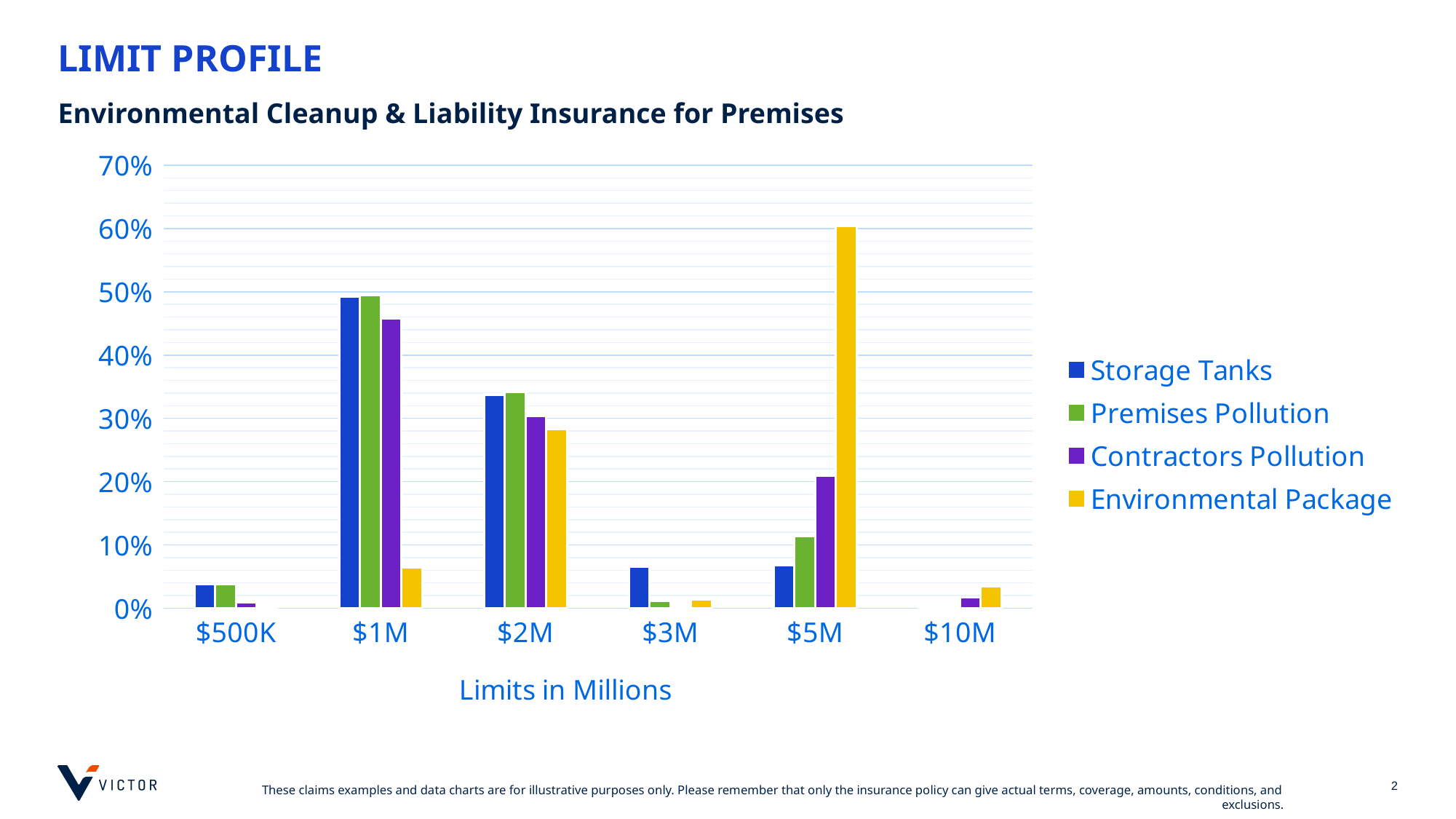
Is the value for Environmental Package at $5M greater or less than 50%? greater What colour represents Environmental Package in the legend? yellow How many limit categories are shown on the x axis? 6 Is the value for Premises Pollution at $2M greater or less than 30%? greater Which series has the lowest bar at the $1M limit? Environmental Package Which series has the tallest bar at the $5M limit? Environmental Package How many series does the legend list? 4 What kind of chart is shown on the slide? bar chart What is the title of the x axis? Limits in Millions Is the value for Contractors Pollution at $5M greater or less than 30%? less At the $1M limit, which is larger: Contractors Pollution or Environmental Package? Contractors Pollution